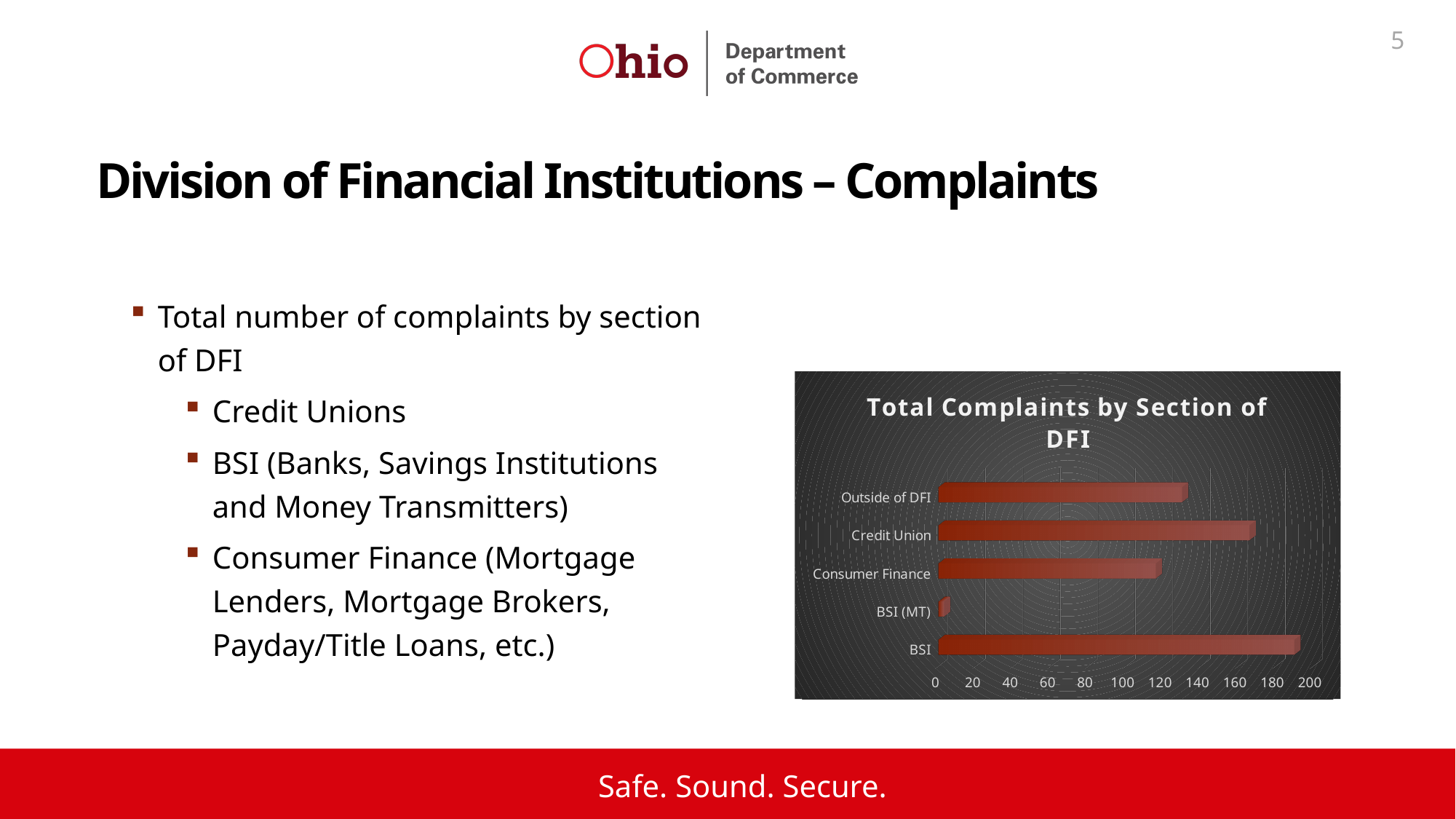
How many categories are plotted in the chart? 5 What kind of chart is shown on the slide? bar chart Is the value for BSI (MT) greater or less than 20? less Is the value for BSI greater or less than 180? greater Is the value for Consumer Finance greater or less than 140? less Which has more complaints, Credit Union or Consumer Finance? Credit Union Which has more complaints, BSI or Outside of DFI? BSI Which section has the highest number of complaints in the chart? BSI What is the title of the chart? Total Complaints by Section of DFI Which section has the lowest number of complaints in the chart? BSI (MT)